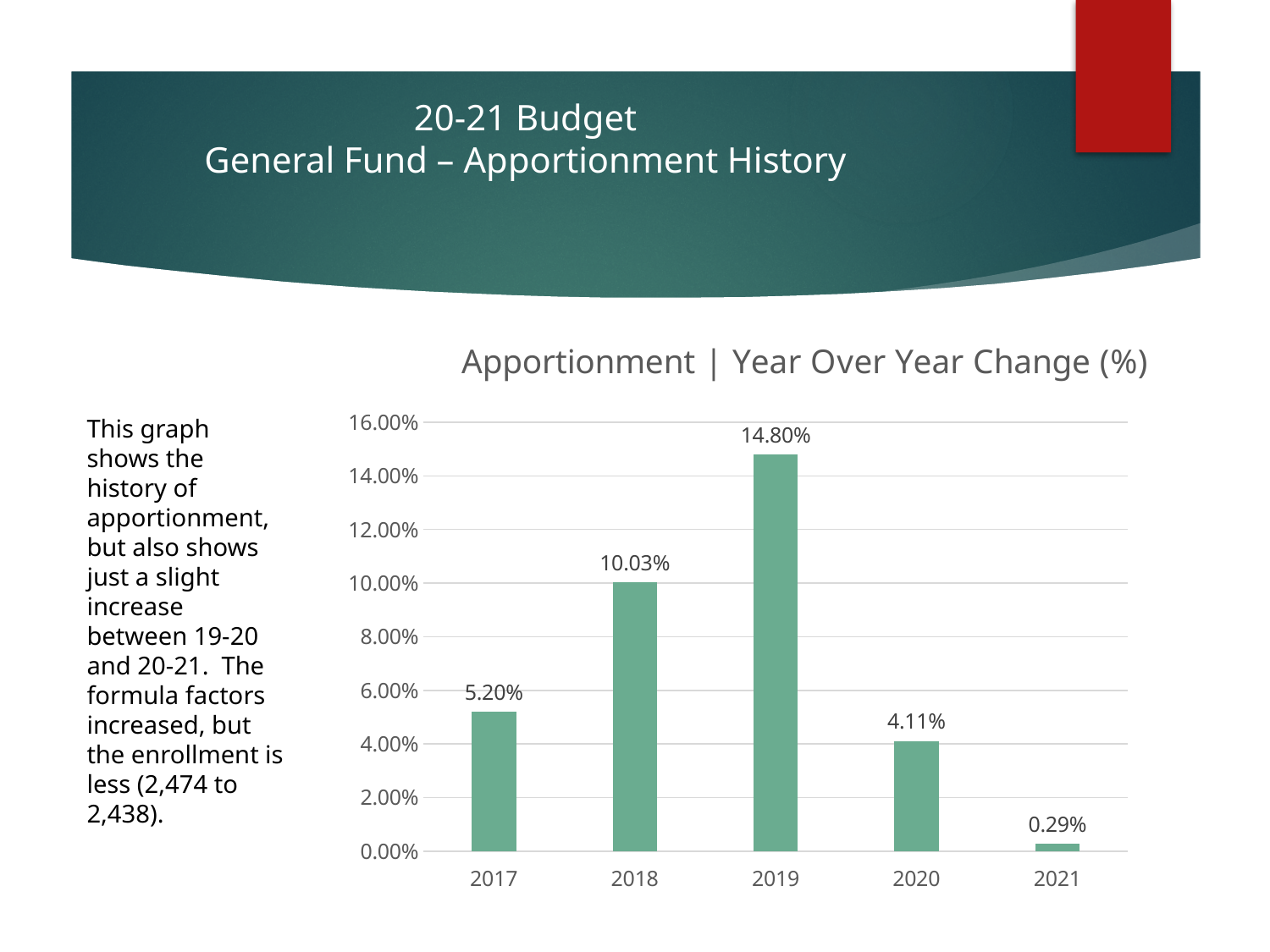
What is the year-over-year change for 2017? 5.20% Is the value for 2018 greater or less than 8.00%? greater What kind of chart is shown on the slide? Bar chart Which is larger, the value for 2018 or the value for 2020? 2018 What is the difference between the 2020 and 2021 values? 3.82% What is the year-over-year change for 2021? 0.29% What is the difference between the 2019 and 2018 values? 4.77% Which year has the lowest year-over-year change? 2021 What is the title of the chart? Apportionment | Year Over Year Change (%) Which year has the highest year-over-year change? 2019 How many years are shown on the chart? 5 What is the year-over-year change for 2019? 14.80%